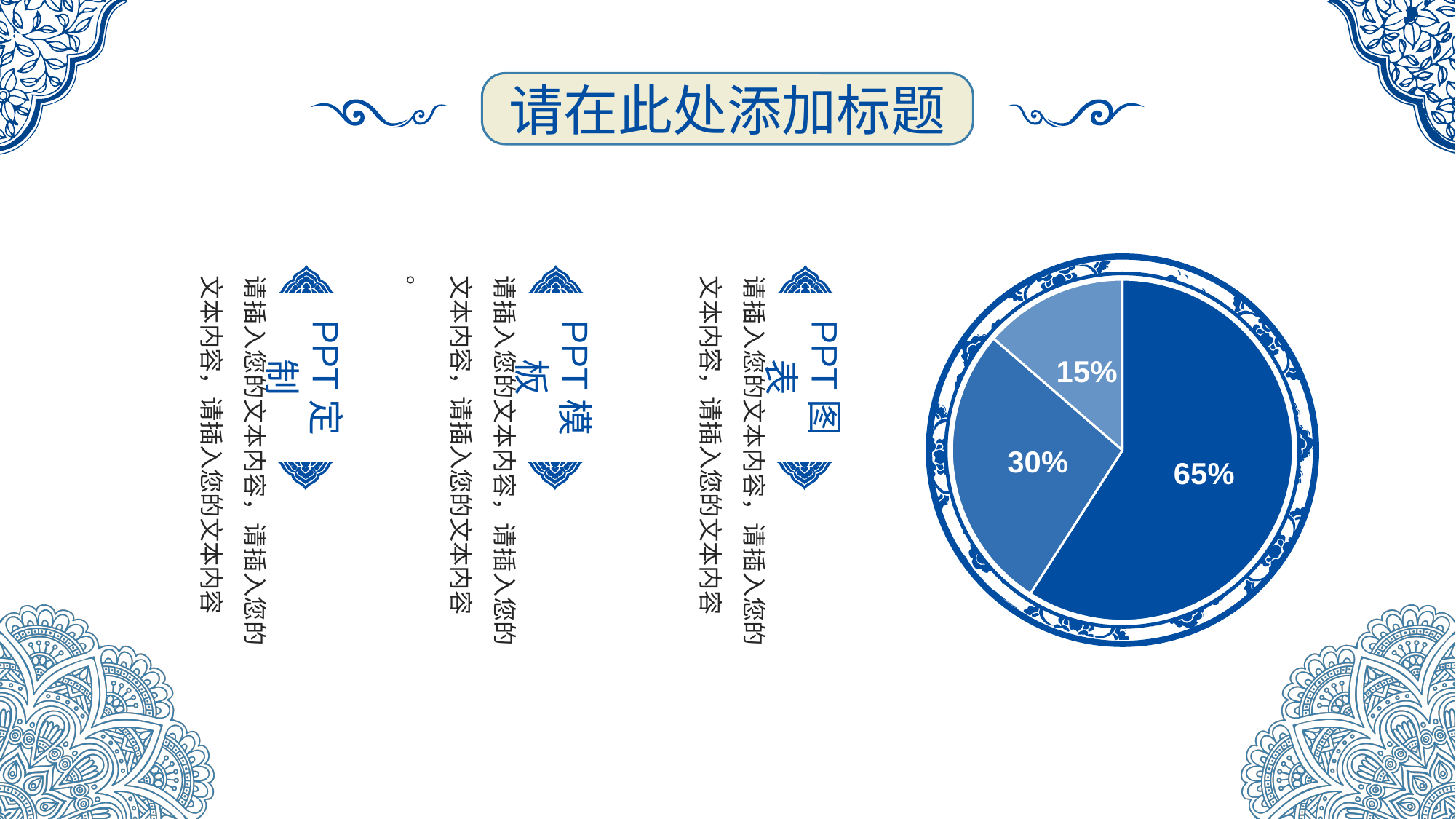
What colour is the largest slice of the pie chart? dark blue What is the value shown on the largest slice of the pie chart? 65% What value is labelled on the darkest blue slice of the pie chart? 65% What is the difference between the 65% slice and the 30% slice in the pie chart? 35% How many slices does the pie chart have? 3 What is the difference between the largest and smallest slice values in the pie chart? 50% Does the pie chart have a legend? No What kind of chart is shown on the slide? pie chart What value is labelled on the lightest blue slice of the pie chart? 15% Which slice is larger in the pie chart, the medium blue slice or the light blue slice? the medium blue slice What value is labelled on the medium blue slice of the pie chart? 30% What is the value shown on the smallest slice of the pie chart? 15%